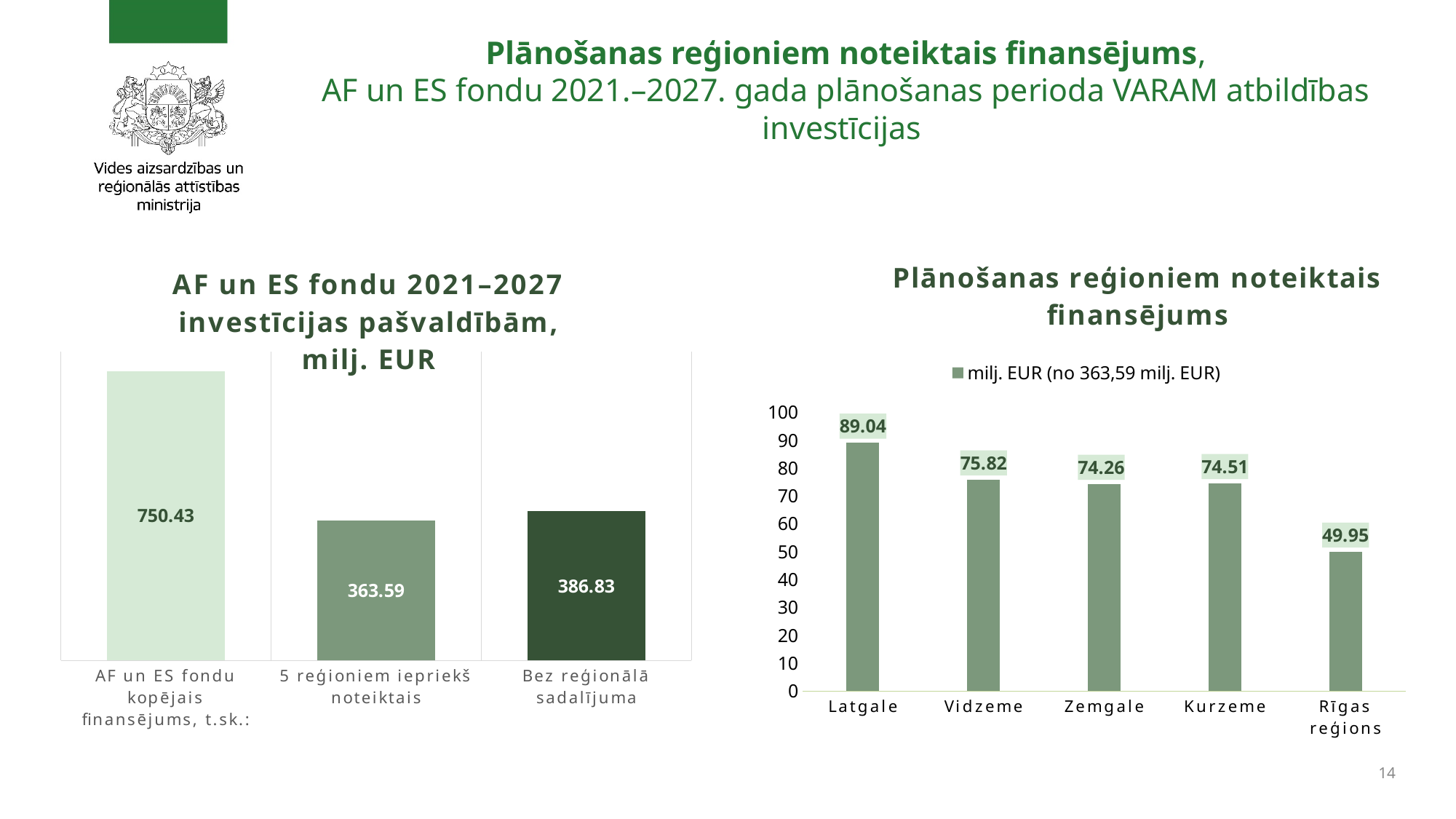
In the chart 'Plānošanas reģioniem noteiktais finansējums', what is the value for Rīgas reģions? 49.95 In the chart 'Plānošanas reģioniem noteiktais finansējums', which region has the lowest value? Rīgas reģions In the left chart 'AF un ES fondu 2021–2027 investīcijas pašvaldībām, milj. EUR', what is the difference between 'Bez reģionālā sadalījuma' and '5 reģioniem iepriekš noteiktais'? 23.24 In the chart 'Plānošanas reģioniem noteiktais finansējums', what is the value for Latgale? 89.04 In the chart 'Plānošanas reģioniem noteiktais finansējums', which region has the highest value? Latgale In the left chart 'AF un ES fondu 2021–2027 investīcijas pašvaldībām, milj. EUR', which category has the highest value? AF un ES fondu kopējais finansējums, t.sk.: In the chart 'Plānošanas reģioniem noteiktais finansējums', how many regions are shown? 5 In the left chart 'AF un ES fondu 2021–2027 investīcijas pašvaldībām, milj. EUR', what is the value for 'Bez reģionālā sadalījuma'? 386.83 What type of chart is the left chart 'AF un ES fondu 2021–2027 investīcijas pašvaldībām, milj. EUR'? bar chart In the left chart 'AF un ES fondu 2021–2027 investīcijas pašvaldībām, milj. EUR', what is the value for '5 reģioniem iepriekš noteiktais'? 363.59 In the chart 'Plānošanas reģioniem noteiktais finansējums', what is the legend entry? milj. EUR (no 363,59 milj. EUR) In the chart 'Plānošanas reģioniem noteiktais finansējums', what is the difference between the values for Latgale and Vidzeme? 13.22